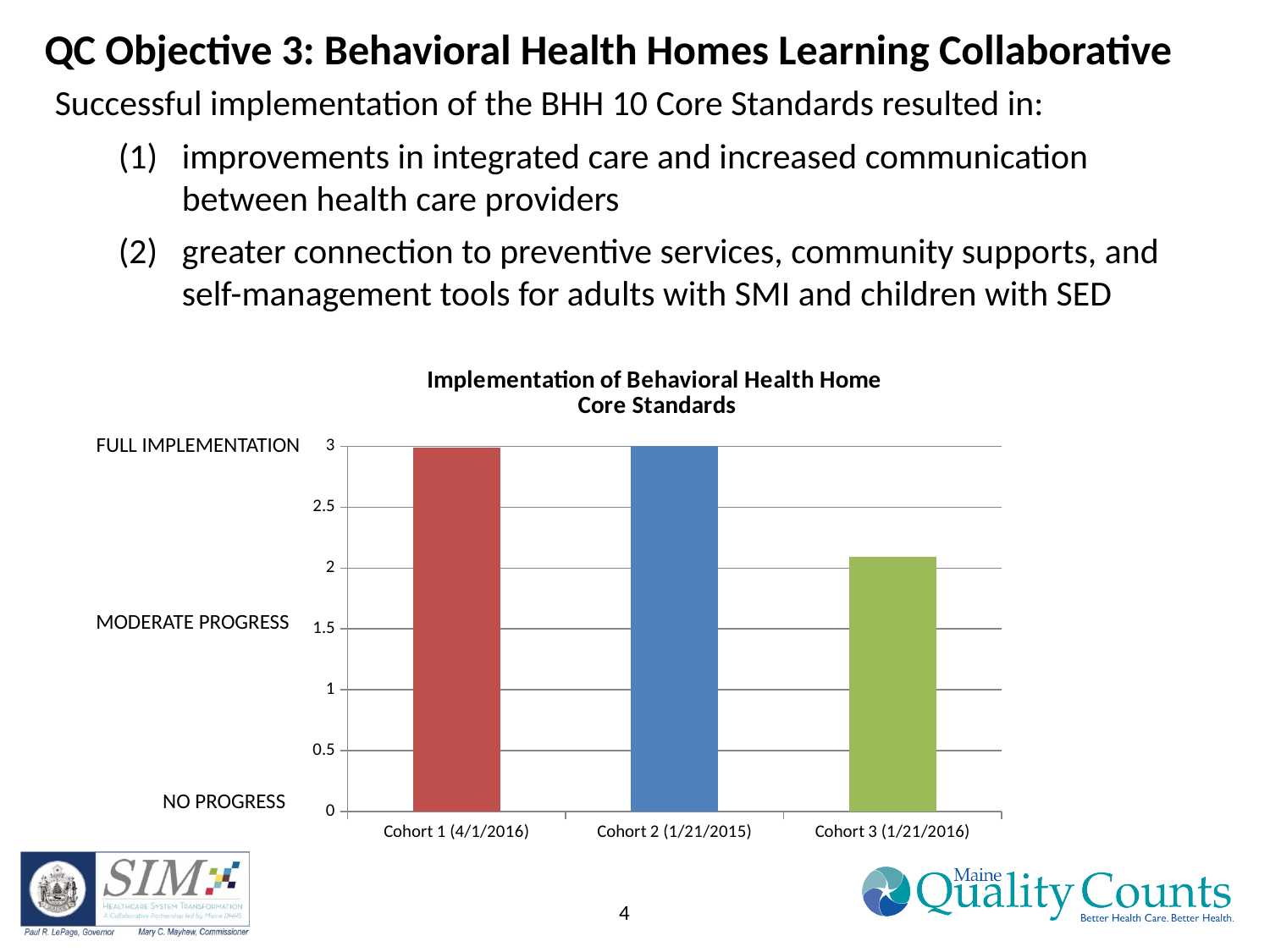
How many cohorts are plotted in the chart? 3 Is the value for Cohort 3 (1/21/2016) greater or less than 2.5? less Is the value for Cohort 3 (1/21/2016) greater or less than 2? greater What label on the vertical axis corresponds to the value 3? FULL IMPLEMENTATION Is the value for Cohort 1 (4/1/2016) greater or less than 2.5? greater Which is larger, the value for Cohort 2 (1/21/2015) or the value for Cohort 3 (1/21/2016)? Cohort 2 (1/21/2015) Which cohort has the lowest value in the chart? Cohort 3 (1/21/2016) Which is larger, the value for Cohort 1 (4/1/2016) or the value for Cohort 3 (1/21/2016)? Cohort 1 (4/1/2016) What is the title of the chart? Implementation of Behavioral Health Home Core Standards What kind of chart is shown on the slide? bar chart